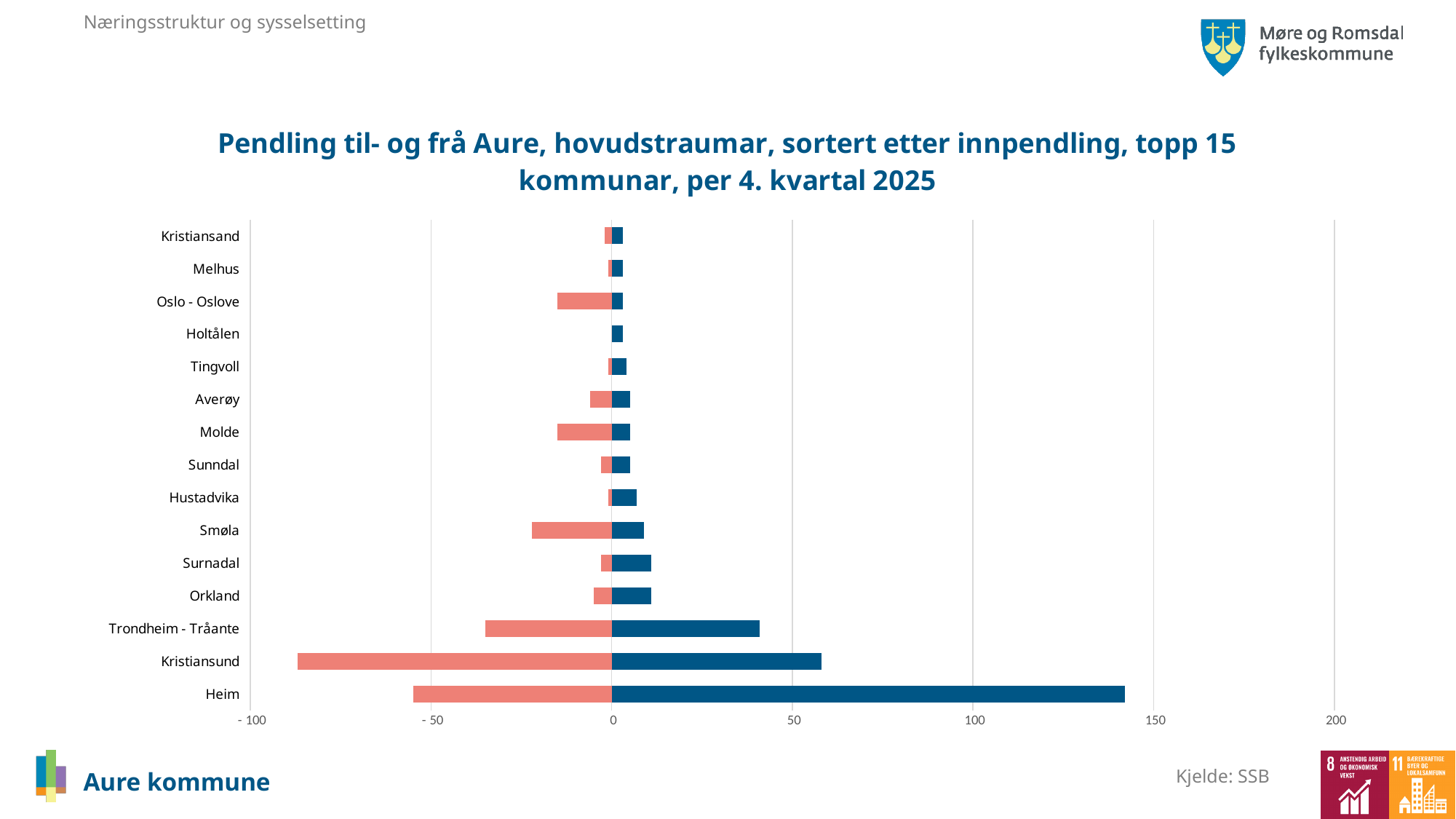
What kind of chart is shown on the slide? bar chart Is the red bar value for Kristiansund greater or less than -50? less Is the blue bar value for Kristiansund greater or less than 50? greater How many municipalities (categories) are listed on the vertical axis of the chart? 15 Is the blue bar value for Heim greater or less than 100? greater What is the highest value shown on the horizontal axis of the chart? 200 Which has the larger blue bar, Heim or Kristiansund? Heim Which municipality has the longest red (negative) bar in the chart? Kristiansund Which municipality has the longest blue (positive) bar in the chart? Heim Which has the longer red (negative) bar, Smøla or Oslo - Oslove? Smøla What is the title of the chart? Pendling til- og frå Aure, hovudstraumar, sortert etter innpendling, topp 15 kommunar, per 4. kvartal 2025